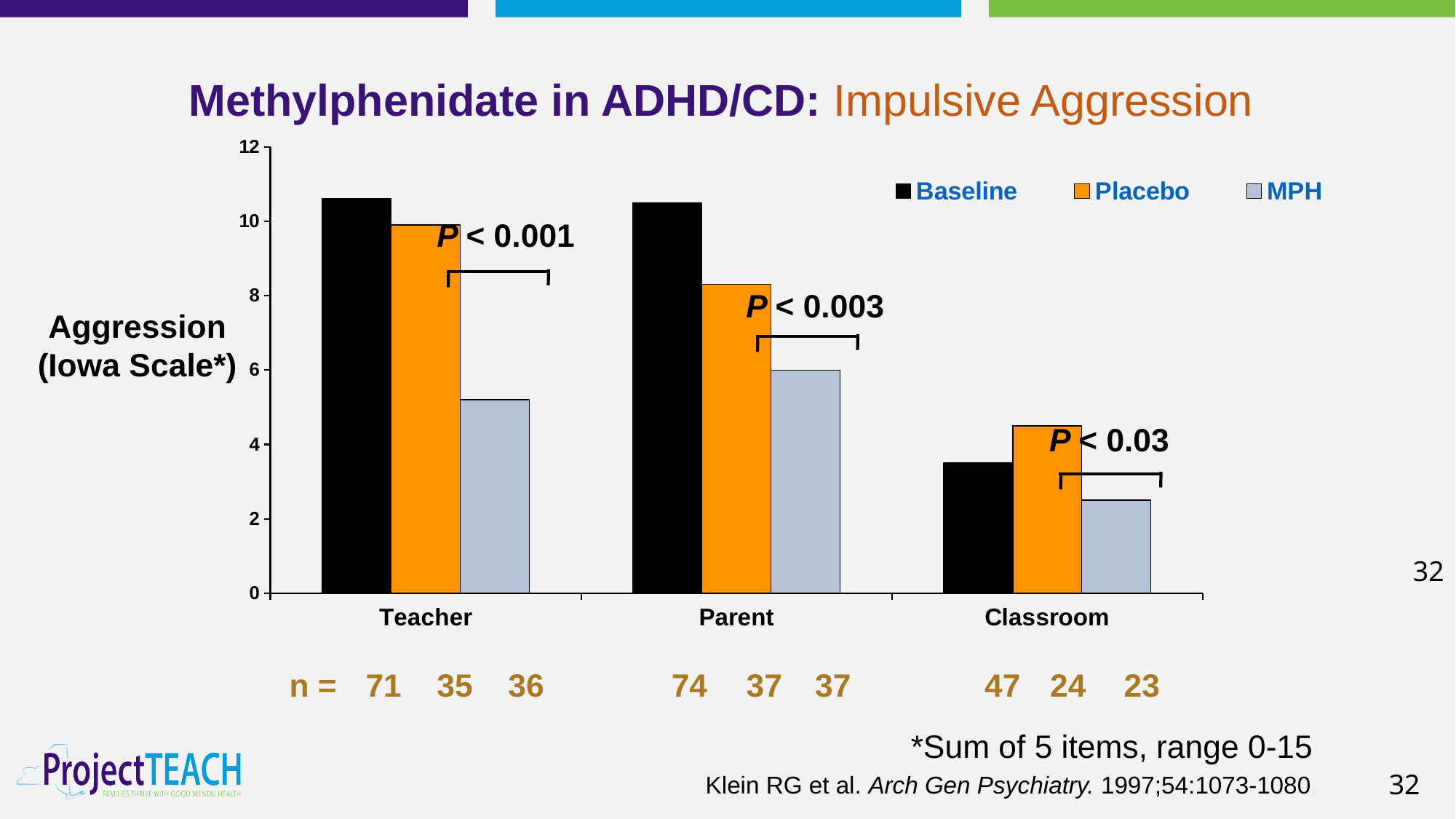
What is the label on the y axis of the chart? Aggression (Iowa Scale*) Is the Placebo value for Parent greater or less than 8? greater Which series has the highest value in the Teacher category? Baseline Is the MPH value for Teacher greater or less than 6? less How many series does the legend list? 3 Is the Baseline value for Classroom greater or less than 4? less What is the n for the Baseline group in the Parent category? 74 What kind of chart is shown on the slide? bar chart How many categories are shown on the x axis? 3 Which series has the lowest value in the Classroom category? MPH In the Classroom category, which is larger: the Baseline bar or the Placebo bar? Placebo